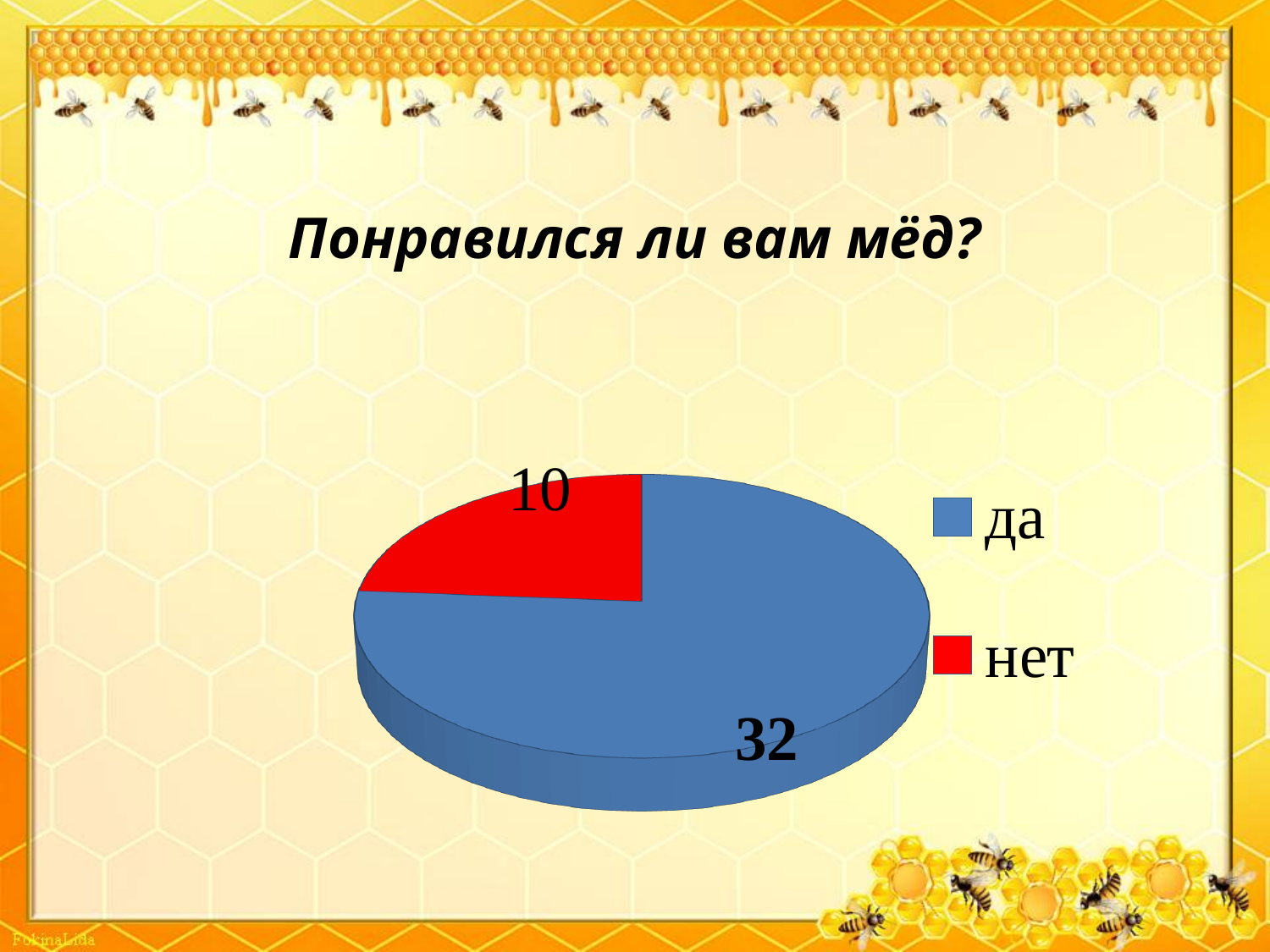
What is the value for "нет" in the pie chart? 10 What is the difference between the values for "да" and "нет"? 22 How many slices does the pie chart have? 2 What is the title of the chart? Понравился ли вам мёд? How many entries does the legend list? 2 Which category has the smallest slice in the pie chart? нет Which is larger, the value for "да" or the value for "нет"? да What kind of chart is shown on the slide? pie chart What is the value for "да" in the pie chart? 32 Which category has the largest slice in the pie chart? да What colour is the slice for "нет"? red What is the total of all slices in the pie chart? 42